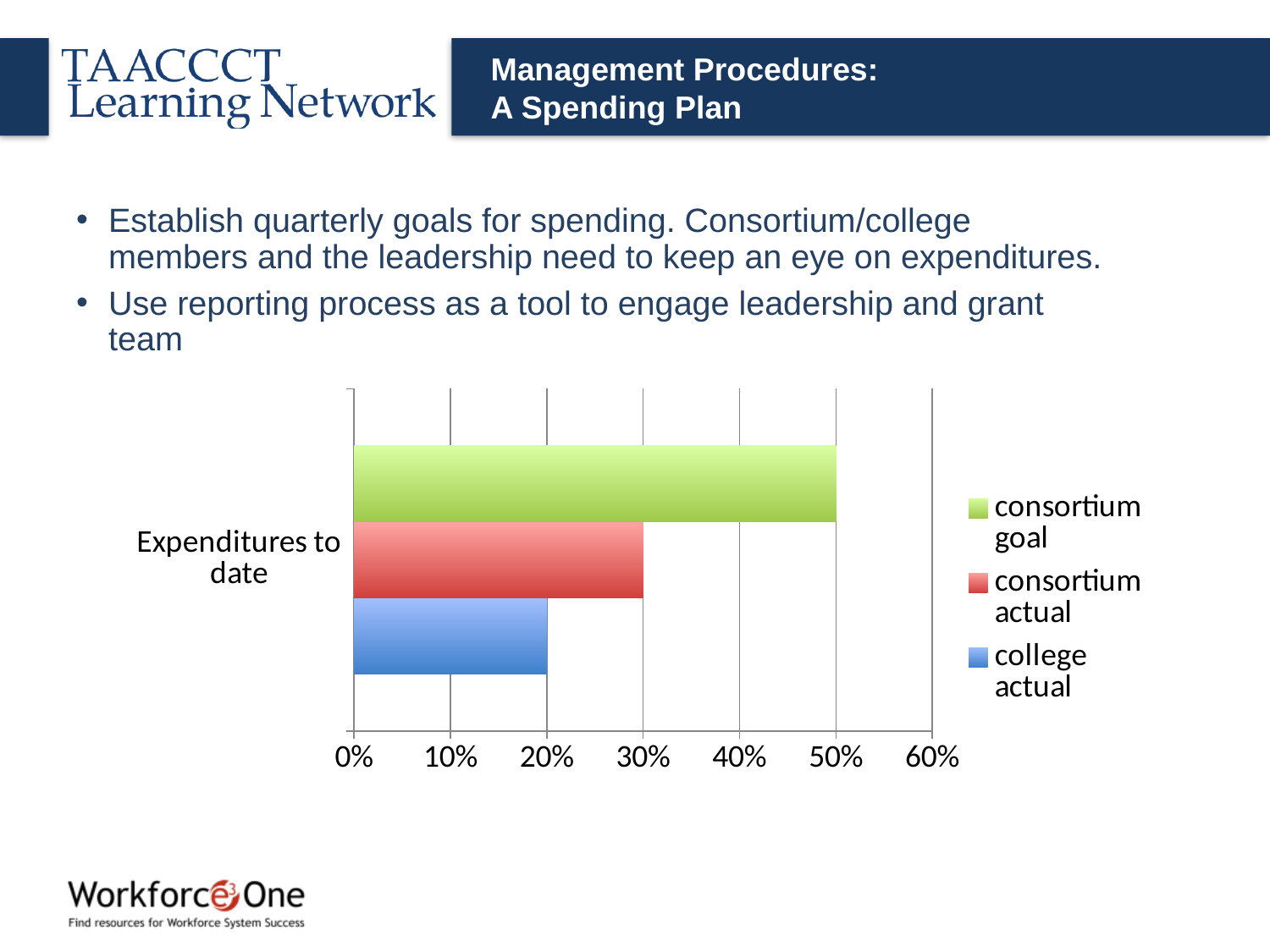
What is the value of the consortium goal bar for Expenditures to date? 50% What kind of chart is shown on the slide? bar chart How many series does the chart legend list? 3 What is the difference between the consortium goal and the consortium actual values? 20% Which series has the highest value for Expenditures to date? consortium goal Which is larger, the consortium actual value or the college actual value? consortium actual What colour is the consortium goal bar in the chart? green What is the value of the consortium actual bar for Expenditures to date? 30% Which series has the lowest value for Expenditures to date? college actual Is the value for college actual greater or less than 40%? less What is the value of the college actual bar for Expenditures to date? 20% How many categories are shown on the chart's vertical axis? 1